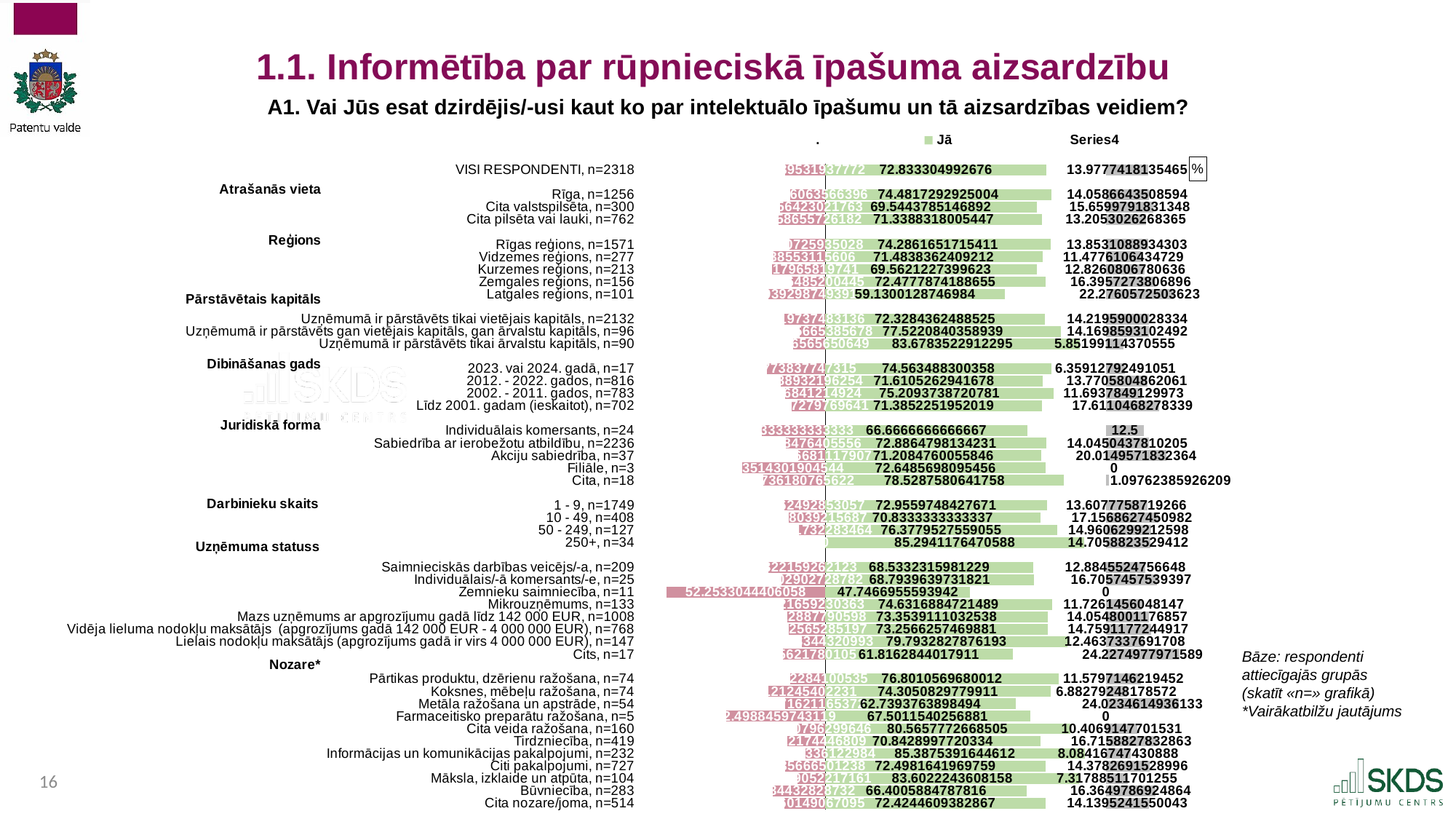
What is the Jā value for VISI RESPONDENTI, n=2318? 72.833304992676 What is the Series4 value for Filiāle, n=3? 0 What kind of chart is shown on the slide? Bar chart Among the Darbinieku skaits categories, which has the highest Jā value? 250+, n=34 What is the Series4 value for Latgales reģions, n=101? 22.2760572503623 Which has a larger Jā value: Rīga, n=1256 or Cita valstspilsēta, n=300? Rīga, n=1256 What is the legend label of the green series? Jā Among the Reģions categories, which has the lowest Jā value? Latgales reģions, n=101 What is the Jā value for Latgales reģions, n=101? 59.1300128746984 What is the Series4 value for Individuālais komersants, n=24? 12.5 What is the Jā value for Zemnieku saimniecība, n=11? 47.7466955539942 How many series does the legend list? 3